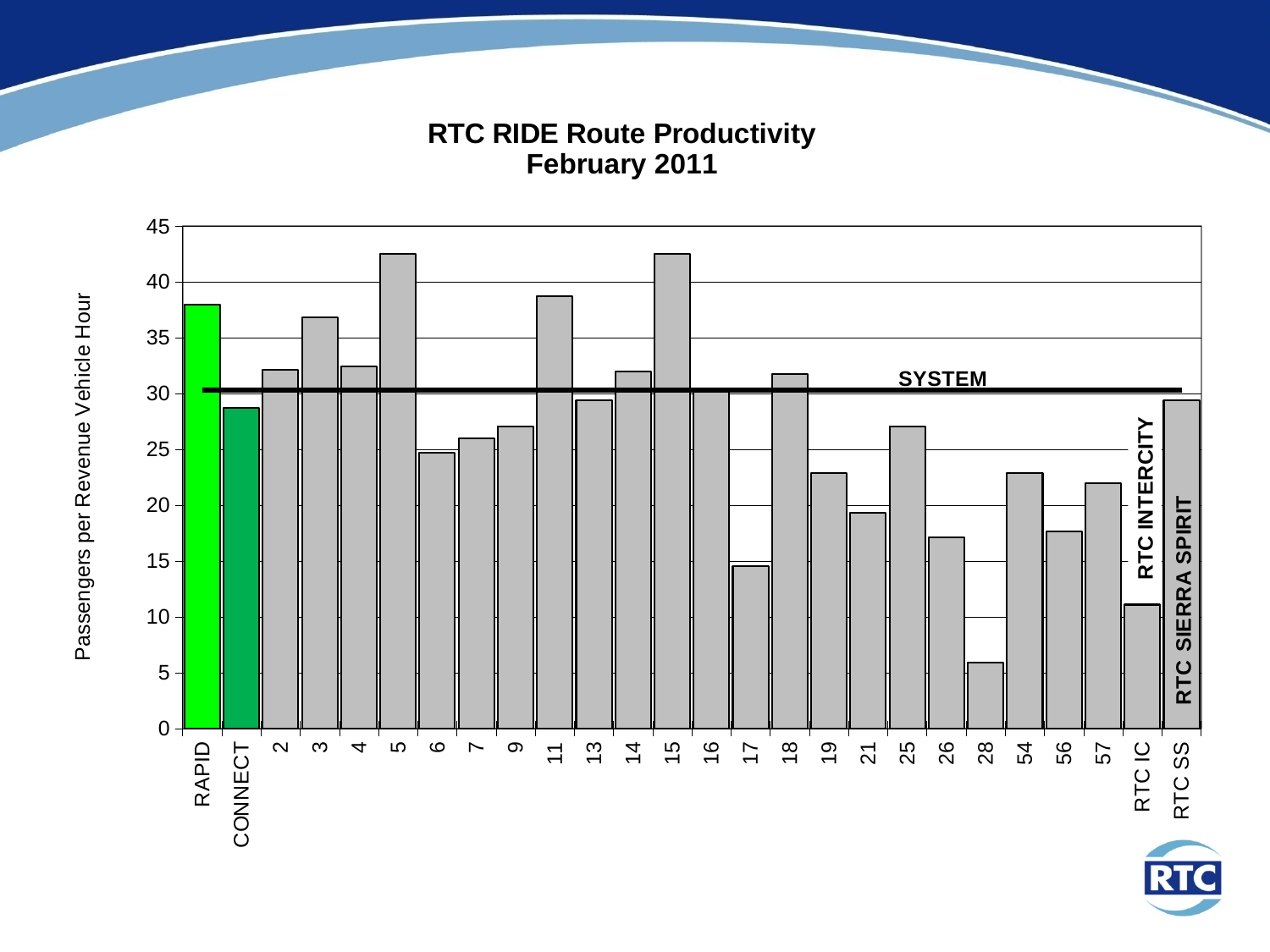
Is the value for RAPID greater or less than 35? greater Which has the higher value, RAPID or CONNECT? RAPID Is the value for route 28 greater or less than 10? less What is the title of the chart? RTC RIDE Route Productivity February 2011 Is the value for route 25 greater or less than 30? less What is the label on the vertical axis? Passengers per Revenue Vehicle Hour What kind of chart is shown on the slide? bar chart Which has the higher value, route 5 or route 17? route 5 How many bars (routes) are plotted on the chart? 26 Which route has the lowest passengers per revenue vehicle hour? 28